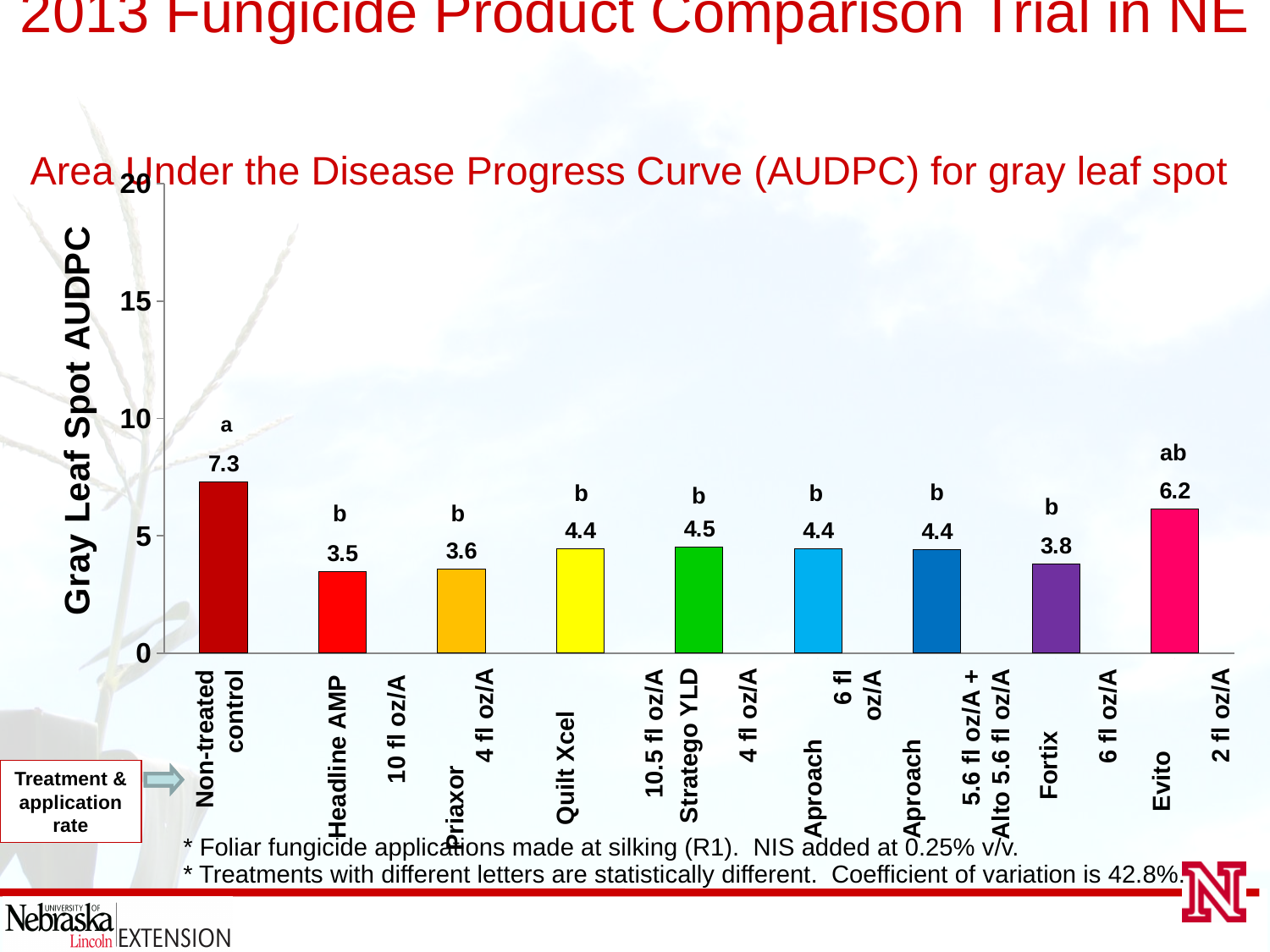
What is the AUDPC value for Fortix? 3.8 What is the difference in AUDPC between the Non-treated control and Headline AMP? 3.8 What is the Gray Leaf Spot AUDPC value for the Non-treated control? 7.3 Which has a higher AUDPC value, Evito or Priaxor? Evito What is the AUDPC value for Headline AMP? 3.5 Is the AUDPC value for the Non-treated control greater or less than 10? less How many treatments (bars) are shown in the chart? 9 Which treatment has the lowest Gray Leaf Spot AUDPC? Headline AMP What statistical letter is shown above the Evito bar? ab Which treatment has the highest Gray Leaf Spot AUDPC? Non-treated control What is the AUDPC value for Evito? 6.2 What type of chart is shown on the slide? Bar chart